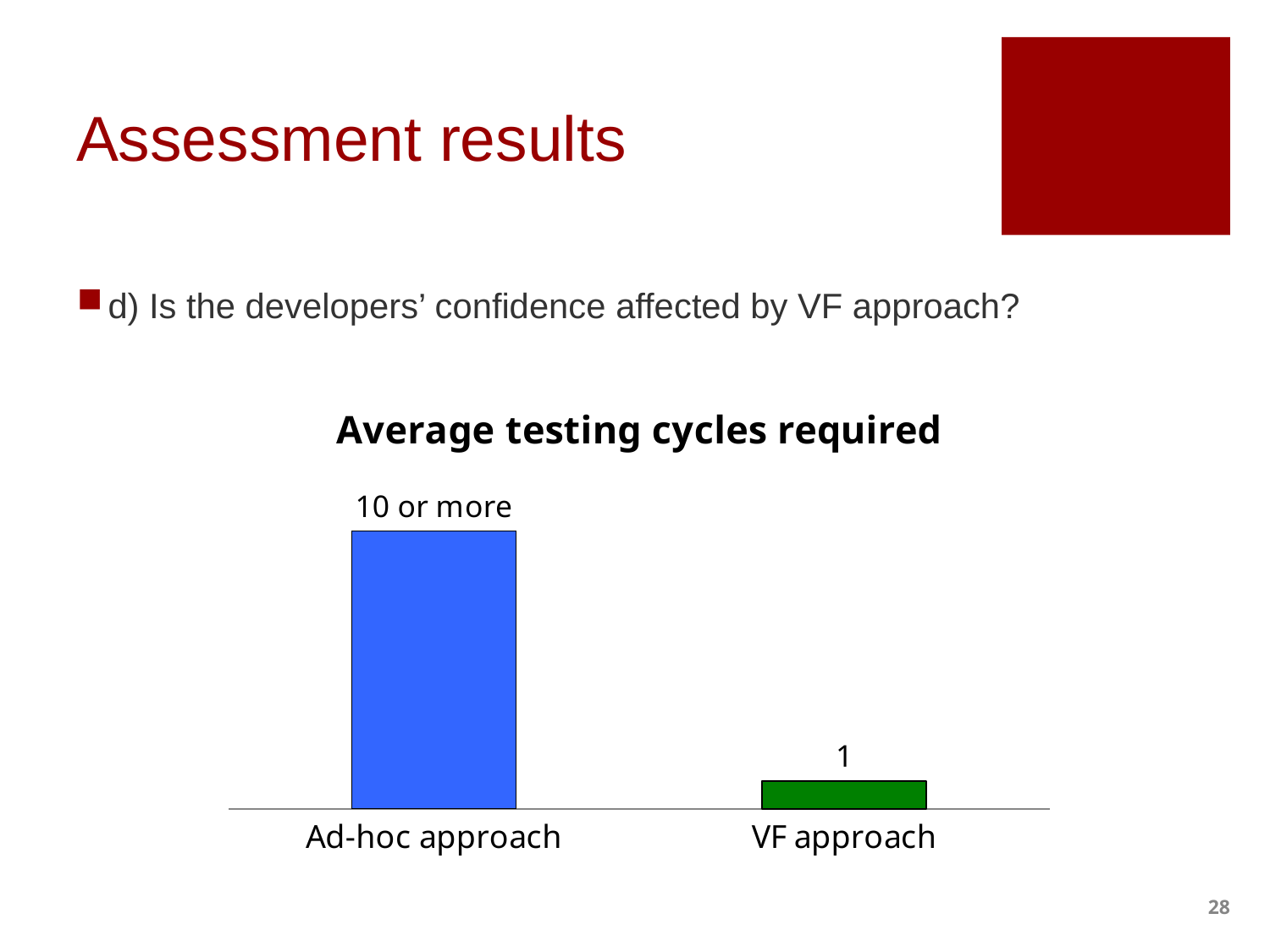
What is the value shown for the VF approach? 1 Which is larger, the value for the Ad-hoc approach or the VF approach? Ad-hoc approach What is the title of the chart? Average testing cycles required Do the values rise or fall from the Ad-hoc approach to the VF approach? fall What is the data label shown for the Ad-hoc approach bar? 10 or more Which approach has the lowest average testing cycles required? VF approach How many categories are shown in the chart? 2 What colour is the bar for the VF approach? green What kind of chart is shown on the slide? bar chart Which approach has the highest average testing cycles required? Ad-hoc approach